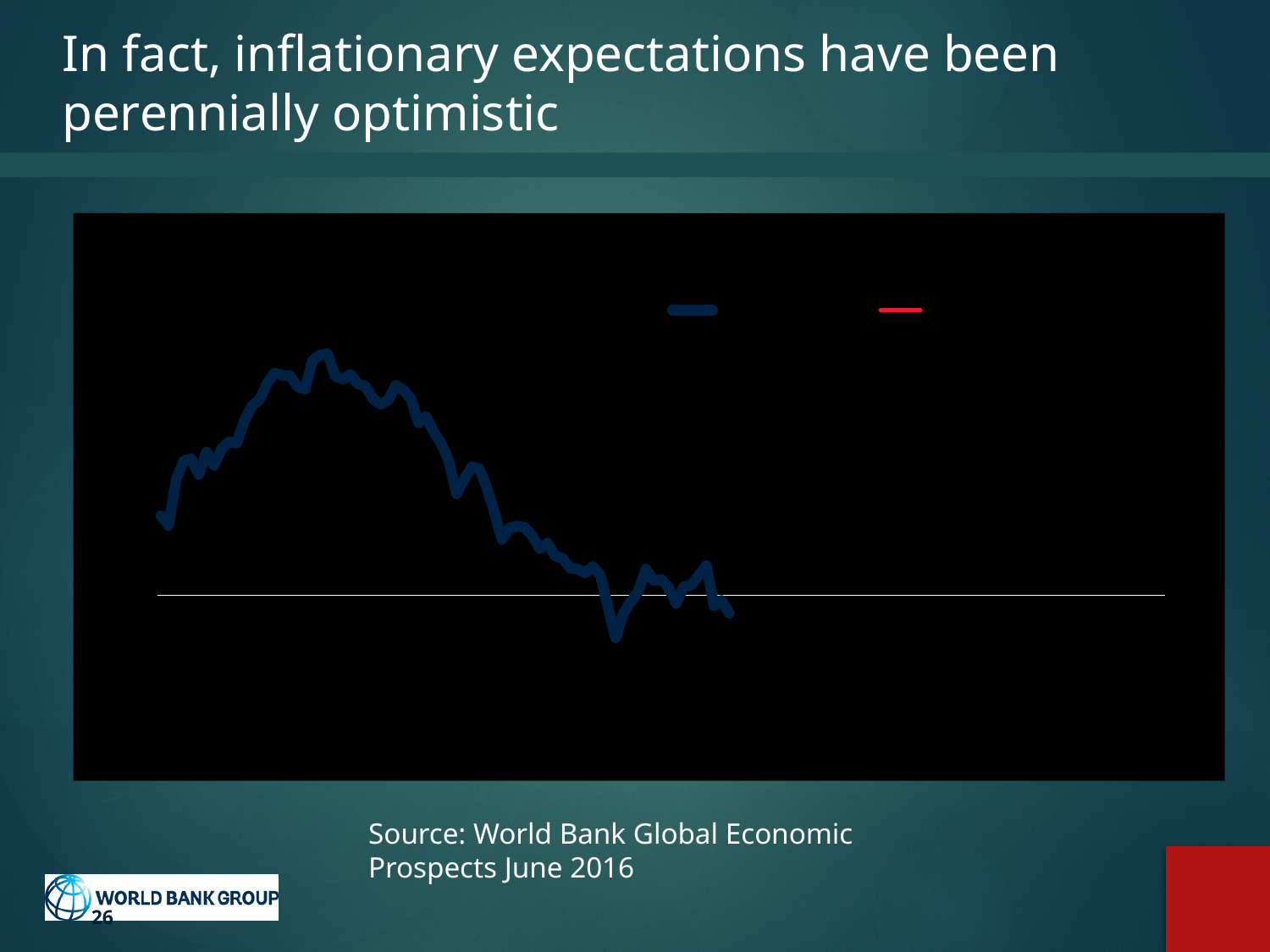
What colour is the plotted line in the chart? dark blue Does the plotted line rise or fall over the right half of its length? fall What kind of chart is shown on the slide? line chart How many series does the legend of the chart show? 2 Does the plotted line end higher or lower than where it starts on the left? lower What colour is the second legend marker in the chart? red